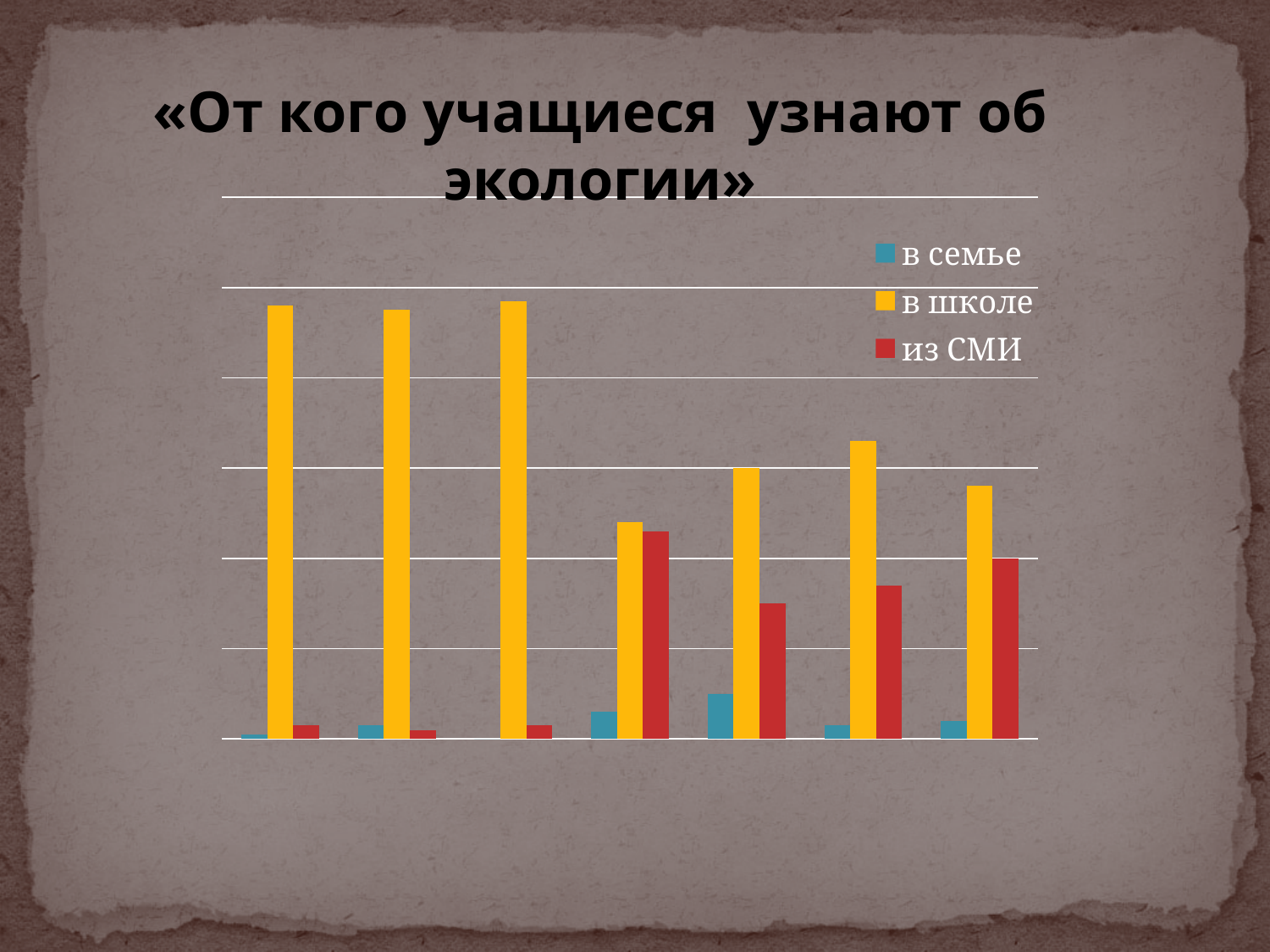
What kind of chart is shown on the slide? bar chart What is the title of the chart? «От кого учащиеся узнают об экологии» Which series has the shortest bars across the chart? в семье In the fourth group of bars from the left, which is larger: в семье or из СМИ? из СМИ How many series does the legend list? 3 How many groups of bars are plotted along the x axis? 7 Which group of bars has the tallest в школе bar: the third group from the left or the fourth group from the left? the third group In the first group of bars from the left, which is larger: в школе or из СМИ? в школе Which series has the tallest bars in every group? в школе Which legend entry is shown in yellow? в школе Do the из СМИ bars in the last four groups generally rise or fall compared with the first three groups? rise